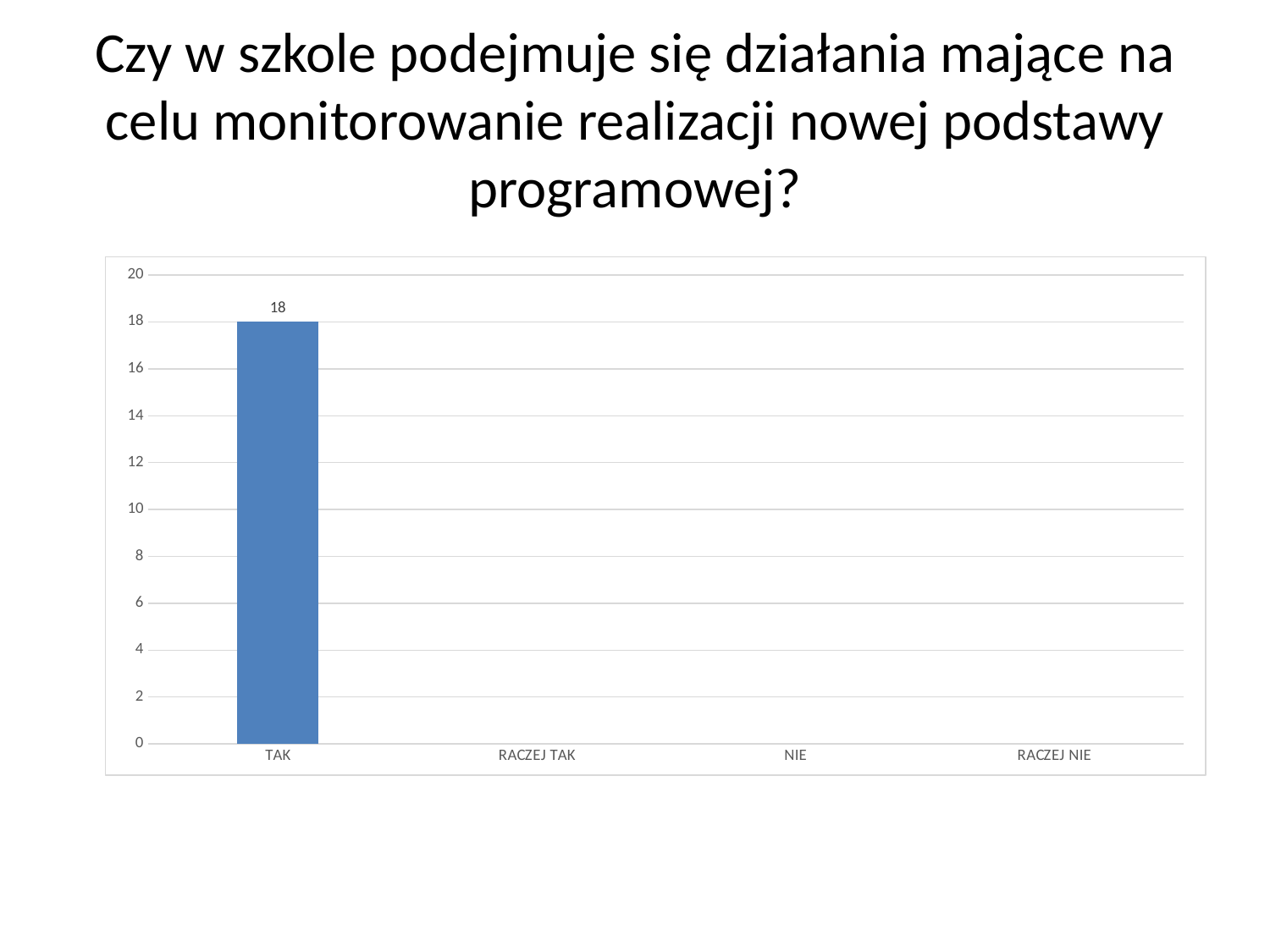
Which is larger, the value for TAK or the value for RACZEJ TAK? TAK What is the value for TAK? 18 Is the value for TAK greater or less than 10? greater Which is larger, the value for TAK or the value for NIE? TAK What is the maximum value shown on the y axis? 20 How many categories are shown on the x axis? 4 Which category has the highest value? TAK What is the title of the slide above the chart? Czy w szkole podejmuje się działania mające na celu monitorowanie realizacji nowej podstawy programowej? What kind of chart is shown on the slide? bar chart Is the value for TAK greater or less than 20? less